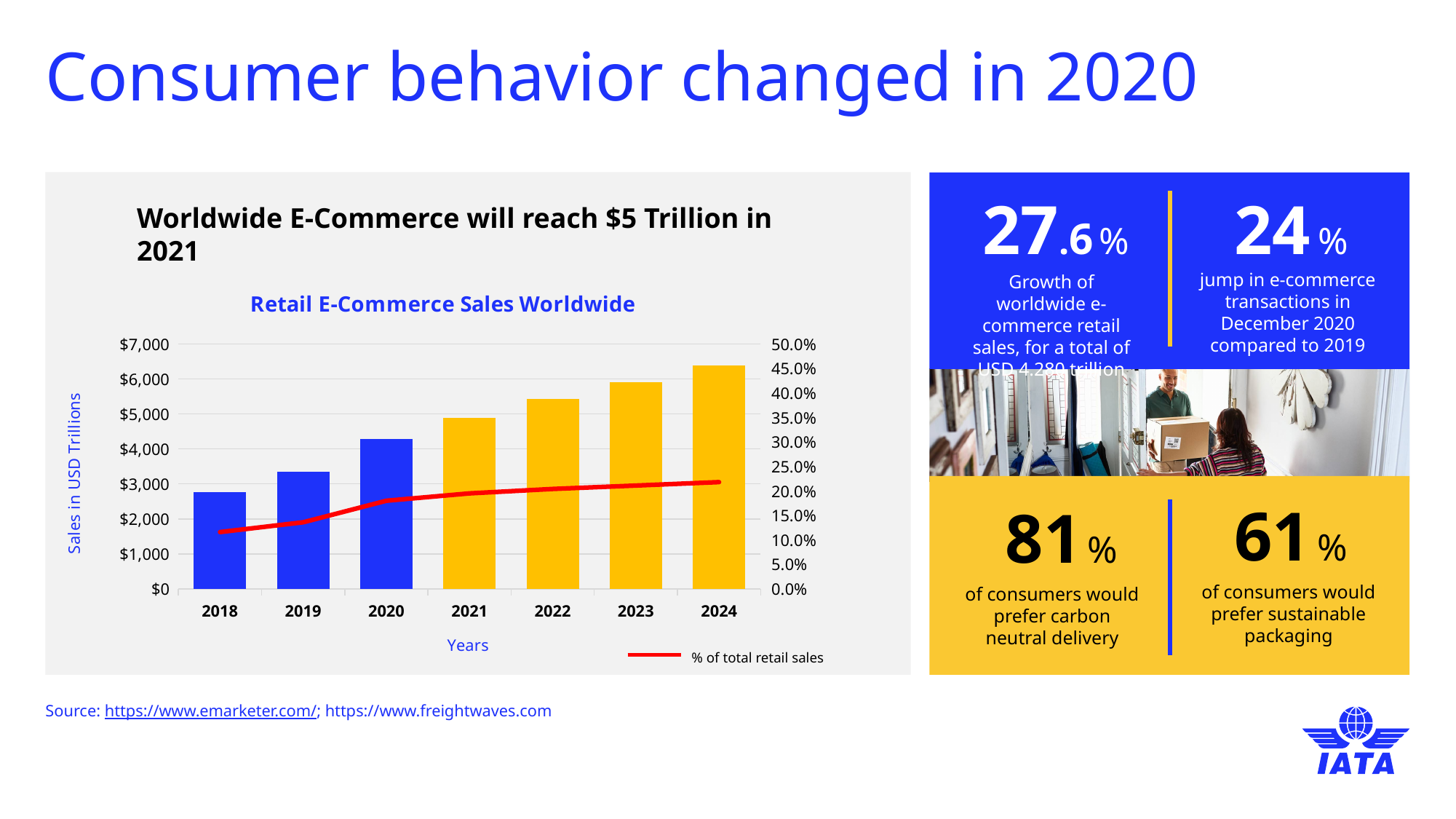
Is the sales value for 2022 greater or less than $5,000? greater Is the sales value for 2024 greater or less than $6,000? greater How many years are shown on the x axis of the Retail E-Commerce Sales Worldwide chart? 7 Which year has the lowest retail e-commerce sales bar? 2018 What is the title of the chart on the left of the slide? Retail E-Commerce Sales Worldwide Is the sales value for 2018 greater or less than $2,000? greater Which year has the highest retail e-commerce sales bar? 2024 What does the red line in the chart represent, according to the legend? % of total retail sales Which year has the larger sales bar, 2019 or 2023? 2023 Do the retail e-commerce sales bars rise or fall from 2018 to 2024? rise What kind of chart is used to show the retail e-commerce sales values by year? bar chart